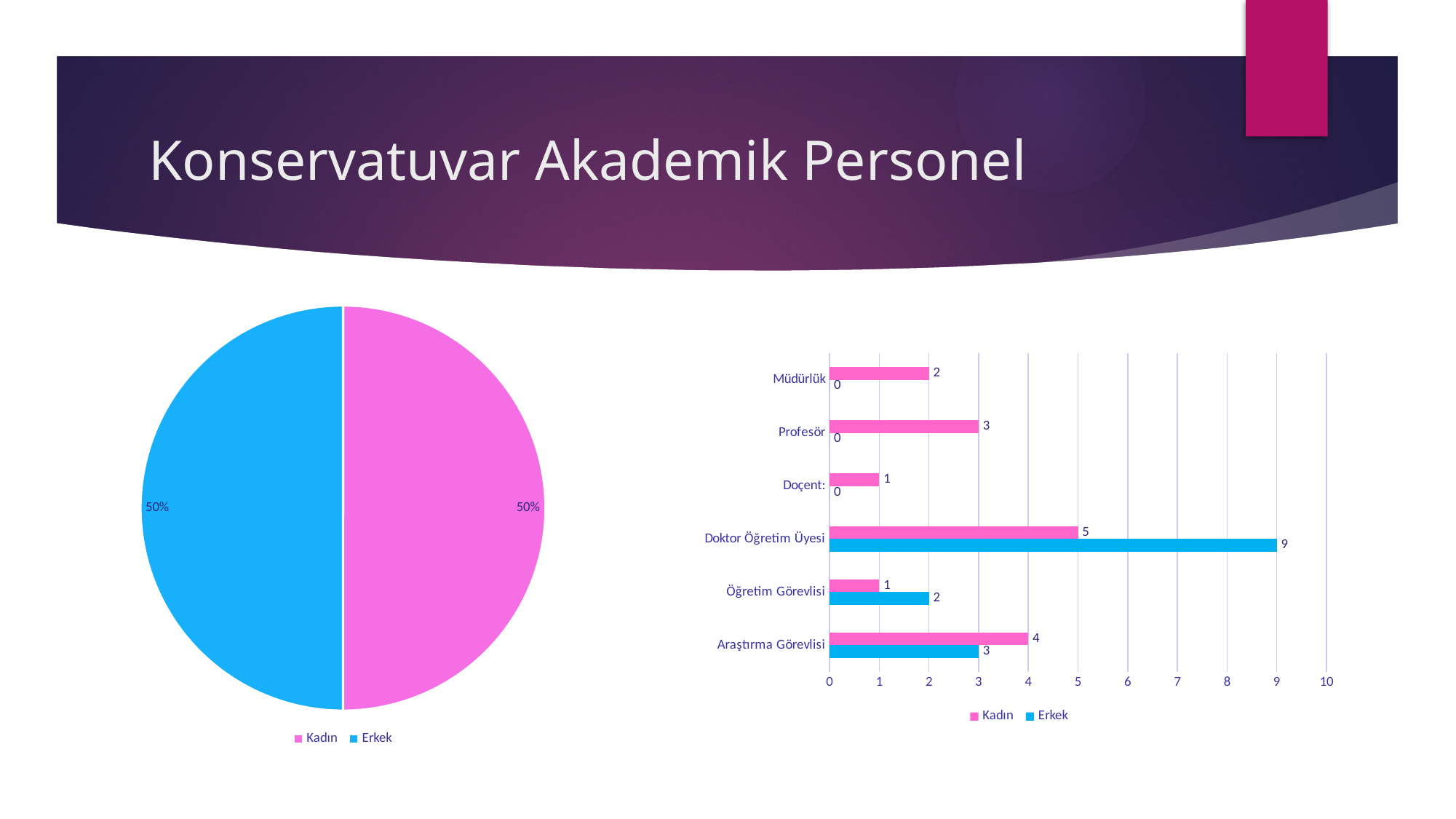
What kind of chart is on the left of the slide? Pie chart In the bar chart on the right, what is the total of the Kadın and Erkek values for Öğretim Görevlisi? 3 In the bar chart on the right, how many series does the legend list? 2 In the bar chart on the right, which is larger for Araştırma Görevlisi, the Kadın value or the Erkek value? Kadın In the pie chart on the left, what share does the Kadın slice have? 50% In the bar chart on the right, what is the difference between the Erkek and Kadın values for Doktor Öğretim Üyesi? 4 In the bar chart on the right, how many categories are shown on the vertical axis? 6 In the bar chart on the right, what is the Kadın value for Profesör? 3 In the bar chart on the right, which category has the highest Kadın value? Doktor Öğretim Üyesi In the bar chart on the right, what is the Kadın value for Araştırma Görevlisi? 4 In the bar chart on the right, what is the Erkek value for Doktor Öğretim Üyesi? 9 In the bar chart on the right, what is the Erkek value for Müdürlük? 0